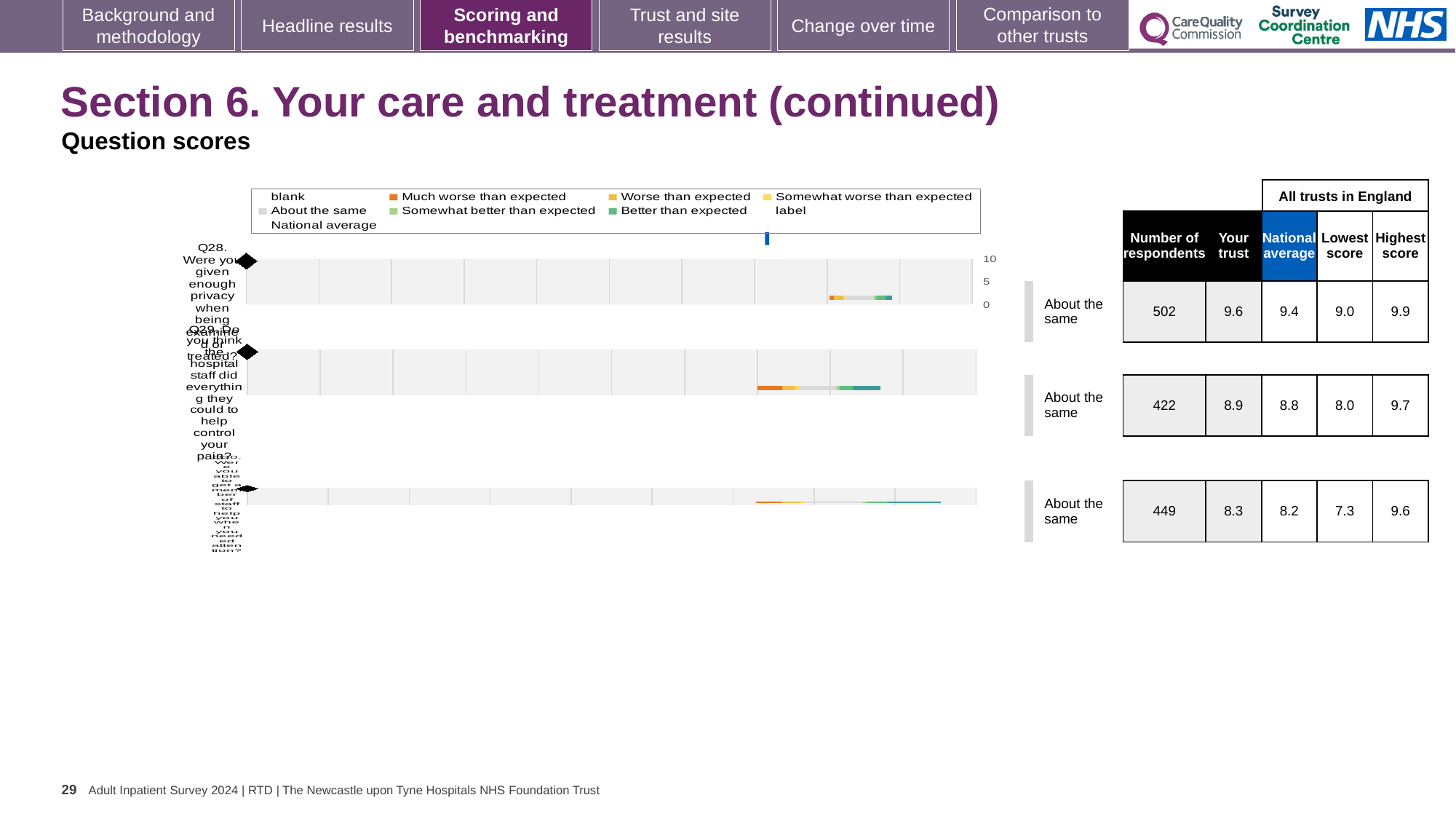
How many questions are plotted in the charts on this slide? 3 What is the 'Your trust' score for Q28 (Were you given enough privacy when being examined or treated?)? 9.6 Which question has the highest 'Your trust' score on this slide? Q28 Is the 'Your trust' score for Q30 greater or less than 5 on the chart axis? greater What kind of chart is used to show the question scores on this slide? bar chart What benchmark category is shown next to each of the three question charts? About the same How many respondents answered Q30 (Were you able to get a member of staff to help you when you needed attention?)? 449 Which question has the lowest 'Lowest score' among all trusts in England? Q30 What is the national average score for Q29 (Do you think the hospital staff did everything they could to help control your pain?)? 8.8 For Q29, which is larger: the 'Your trust' score or the national average? Your trust How many entries does the chart legend list? 9 For Q28, what is the difference between the highest score and the lowest score among all trusts in England? 0.9